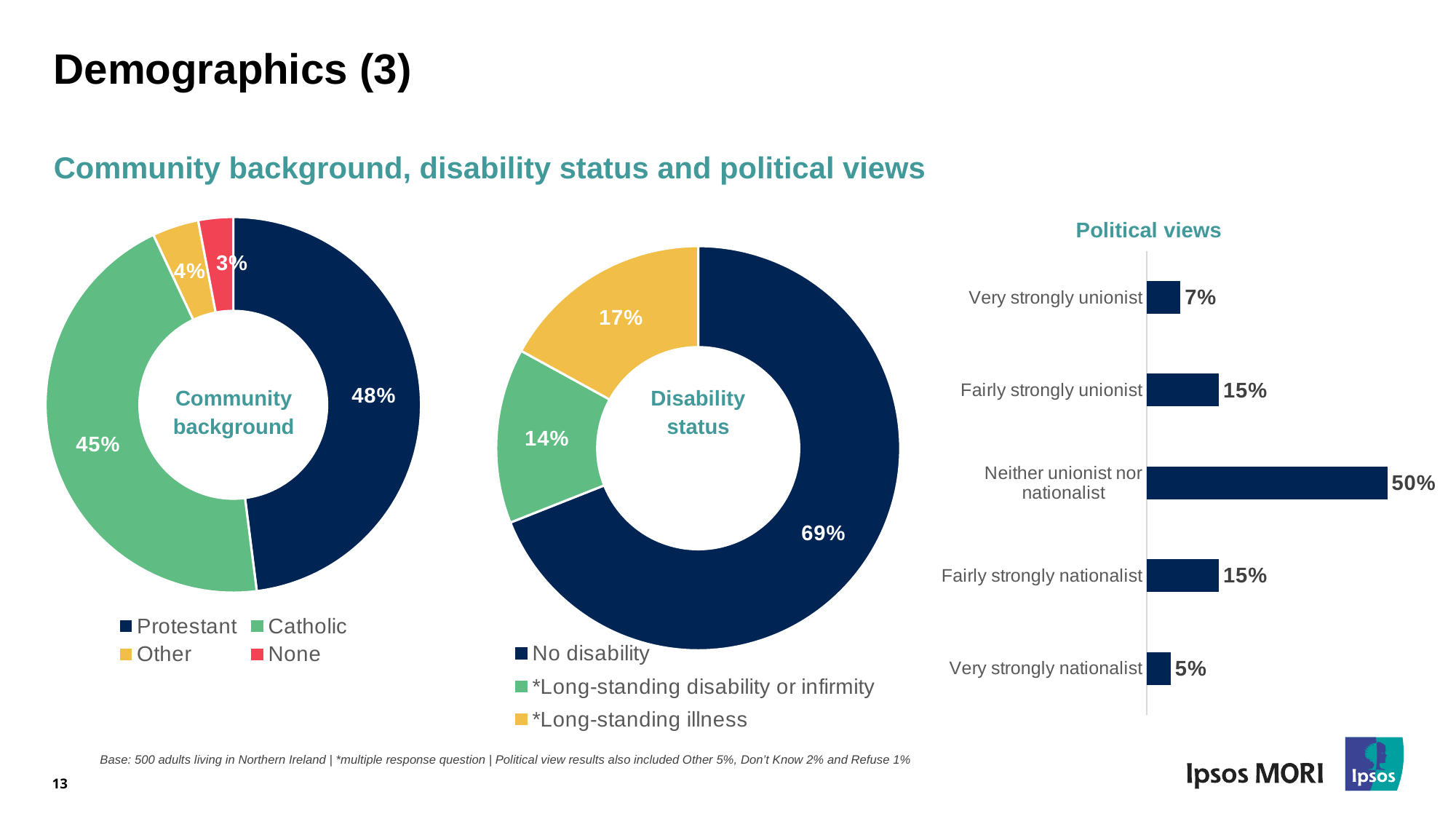
In the Community background chart, what is the difference between the Protestant and Catholic shares? 3% In the Disability status chart, what percentage is No disability? 69% In the Community background chart, what percentage is Protestant? 48% In the Disability status chart, which is larger: Long-standing disability or infirmity, or Long-standing illness? Long-standing illness In the Political views chart, what is the difference between Fairly strongly unionist and Very strongly unionist? 8% In the Political views chart, which category has the lowest value? Very strongly nationalist What kind of chart is the Political views chart? Bar chart In the Political views chart, what is the value for Neither unionist nor nationalist? 50% In the Disability status chart, how many categories does the legend list? 3 In the Community background chart, which category has the smallest share? None In the Disability status chart, what percentage is Long-standing illness? 17% In the Community background chart, what percentage is Catholic? 45%